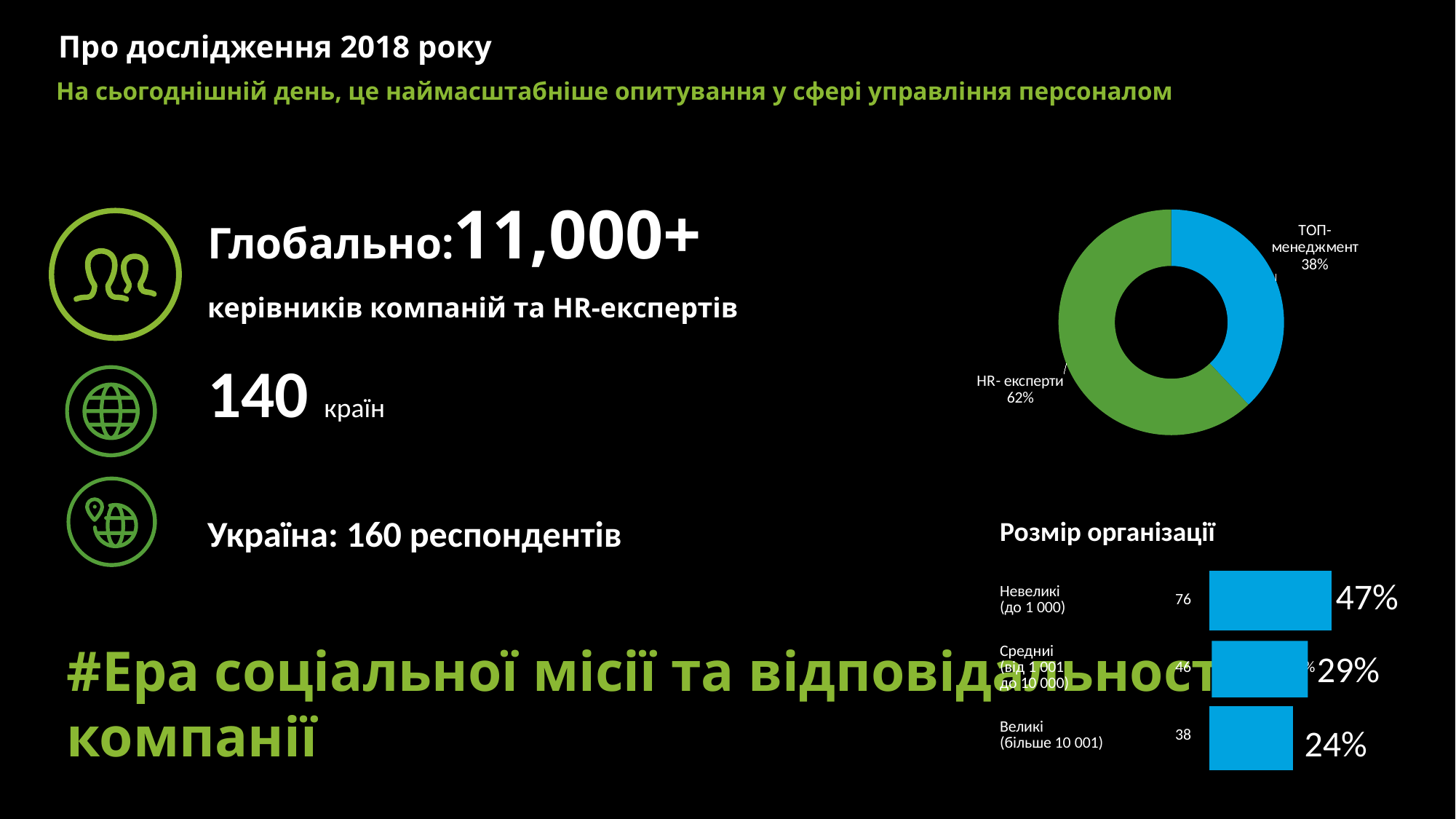
In the 'Розмір організації' chart, what percentage is shown for Невеликі (до 1 000)? 47% In the 'Розмір організації' chart, what percentage is shown for Великі (більше 10 001)? 24% In the 'Розмір організації' chart, which organisation size has the lowest percentage? Великі (більше 10 001) In the donut chart, what is the difference in percentage points between the HR-експерти share and the ТОП-менеджмент share? 24 In the 'Розмір організації' chart, what count is shown next to Невеликі (до 1 000)? 76 In the donut chart, what share of respondents are HR-експерти? 62% In the 'Розмір організації' chart, which organisation size has the highest percentage? Невеликі (до 1 000) What type of chart is the one showing HR-експерти and ТОП-менеджмент? Donut (pie) chart How many slices does the donut chart have? 2 What type of chart is the 'Розмір організації' chart? Bar chart In the donut chart, which group has the larger share, HR-експерти or ТОП-менеджмент? HR-експерти In the donut chart, what share of respondents are ТОП-менеджмент? 38%